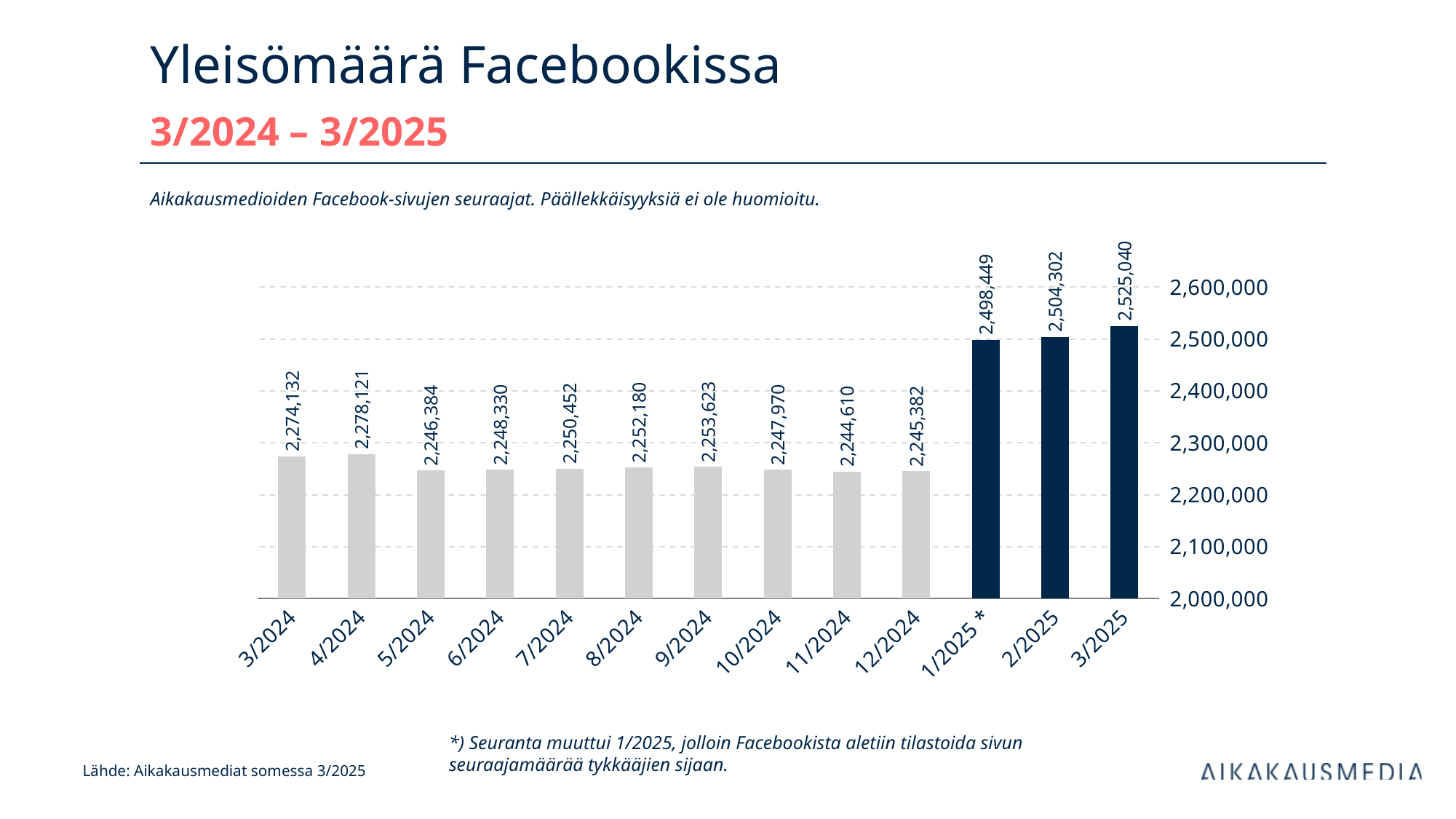
What is the title of the chart on the slide? Yleisömäärä Facebookissa What is the difference between the values for 3/2025 and 3/2024? 250,908 What is the value for 3/2025? 2,525,040 Which month has the highest value? 3/2025 What kind of chart is shown on the slide? bar chart What is the value for 1/2025 *? 2,498,449 Which is larger, the value for 4/2024 or the value for 3/2024? 4/2024 How many months are shown on the x axis? 13 What is the difference between the values for 2/2025 and 1/2025 *? 5,853 Which month has the lowest value? 11/2024 Is the value for 1/2025 * greater or less than 2,400,000? greater What is the value for 9/2024? 2,253,623